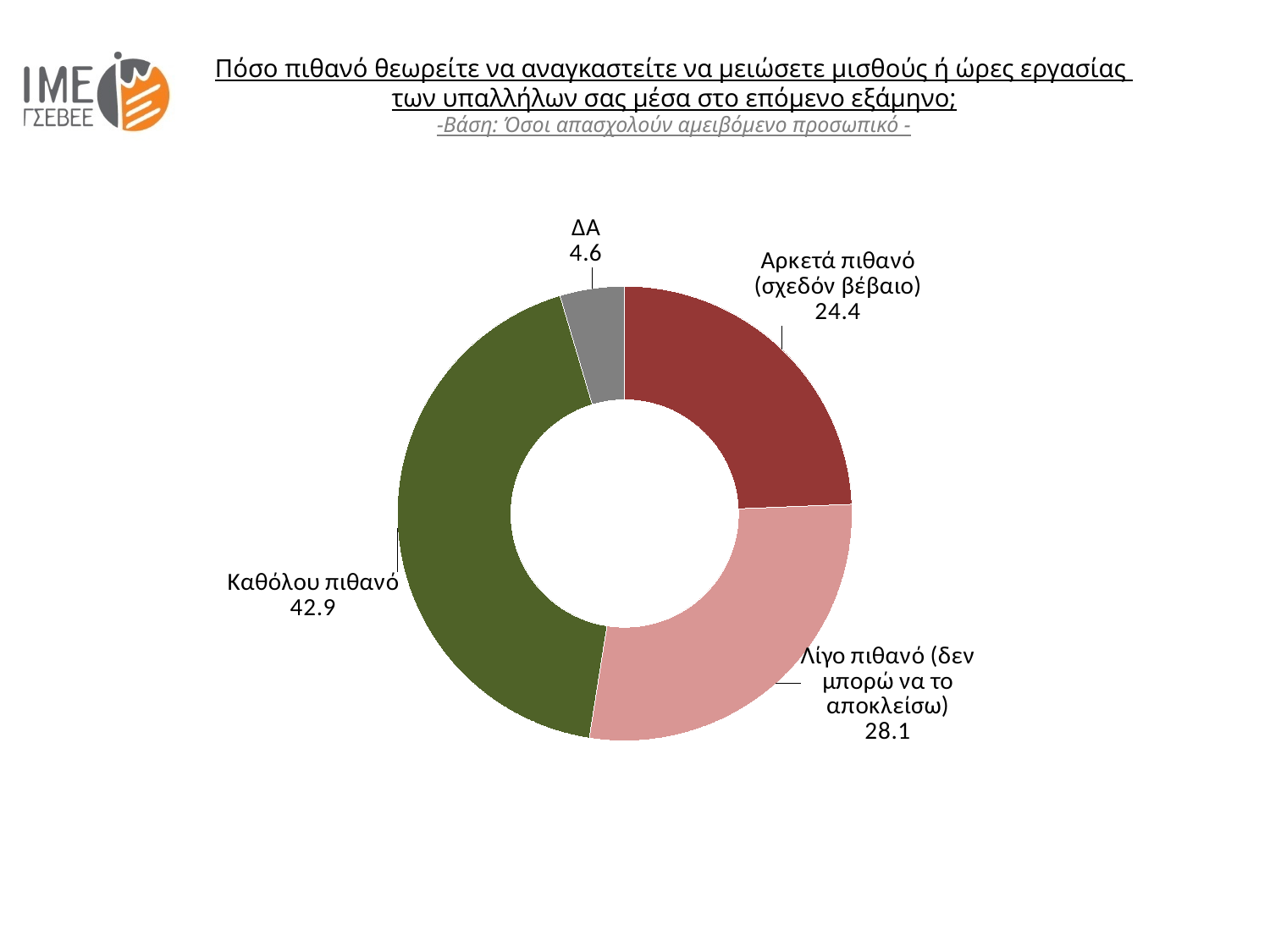
What value is shown for the 'Καθόλου πιθανό' slice? 42.9 What colour is the 'Καθόλου πιθανό' slice? Green Which category has the smallest slice? ΔΑ What is the difference between the values for 'Καθόλου πιθανό' and 'Αρκετά πιθανό (σχεδόν βέβαιο)'? 18.5 Which category has the largest slice? Καθόλου πιθανό Which is larger: 'Λίγο πιθανό (δεν μπορώ να το αποκλείσω)' or 'Αρκετά πιθανό (σχεδόν βέβαιο)'? Λίγο πιθανό (δεν μπορώ να το αποκλείσω) What value is shown for the 'ΔΑ' slice? 4.6 How many slices does the chart have? 4 What value is shown for the 'Αρκετά πιθανό (σχεδόν βέβαιο)' slice? 24.4 What is the difference between the values for 'Λίγο πιθανό (δεν μπορώ να το αποκλείσω)' and 'ΔΑ'? 23.5 What kind of chart is shown on the slide? Doughnut (pie) chart What value is shown for the 'Λίγο πιθανό (δεν μπορώ να το αποκλείσω)' slice? 28.1